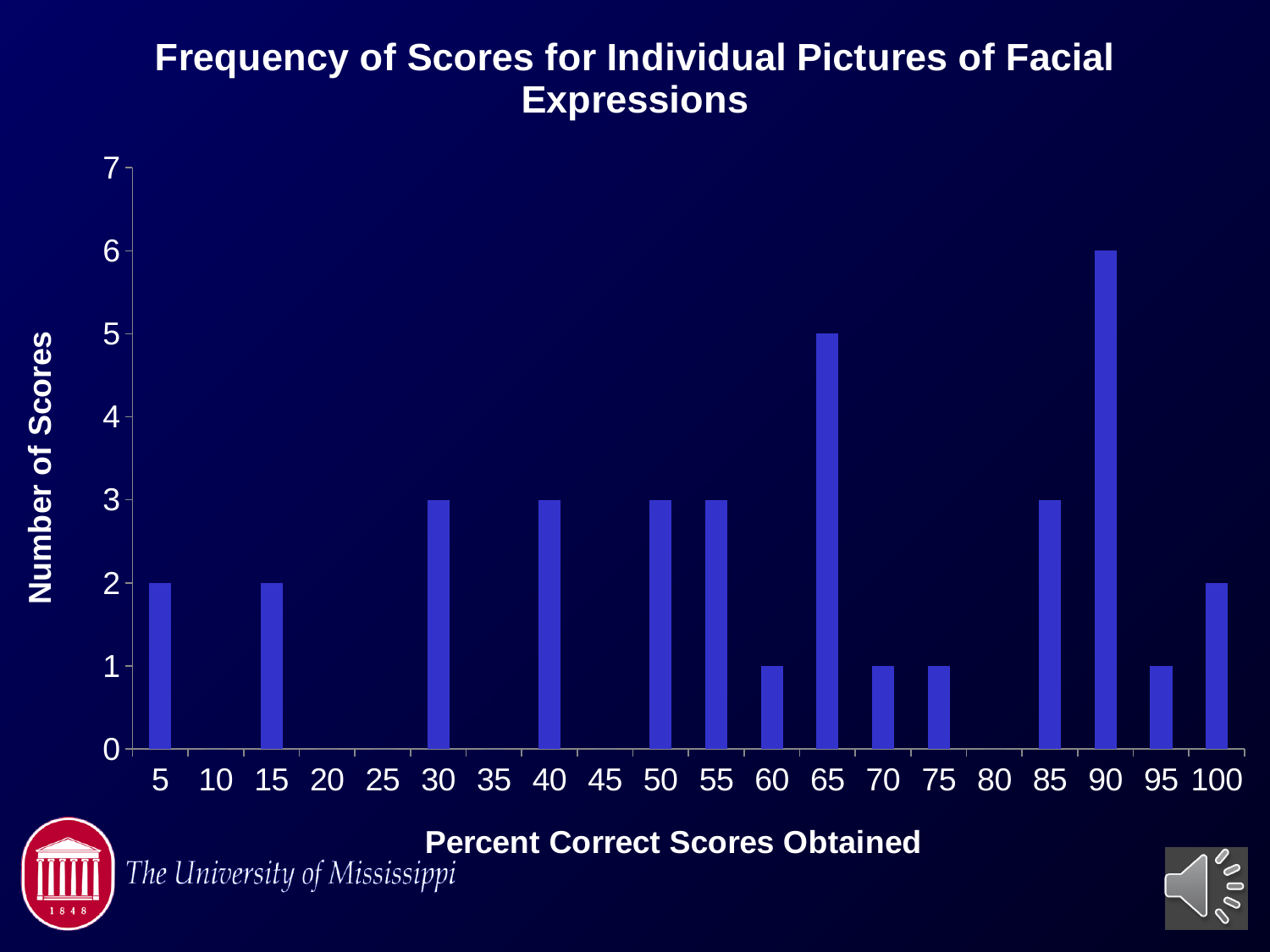
What is the number of scores for the 65 percent correct category? 5 What is the difference in number of scores between the 90 and 65 percent correct categories? 1 How many percent correct score categories are labeled on the x axis? 20 What type of chart is shown on the slide? bar chart Which percent correct score category has the highest number of scores? 90 What is the number of scores for the 90 percent correct category? 6 What is the number of scores for the 30 percent correct category? 3 What is the label of the y axis? Number of Scores What is the number of scores for the 100 percent correct category? 2 Which has more scores, the 65 percent correct category or the 85 percent correct category? 65 What is the title of the chart? Frequency of Scores for Individual Pictures of Facial Expressions Is the number of scores for the 90 percent correct category greater or less than 5? greater